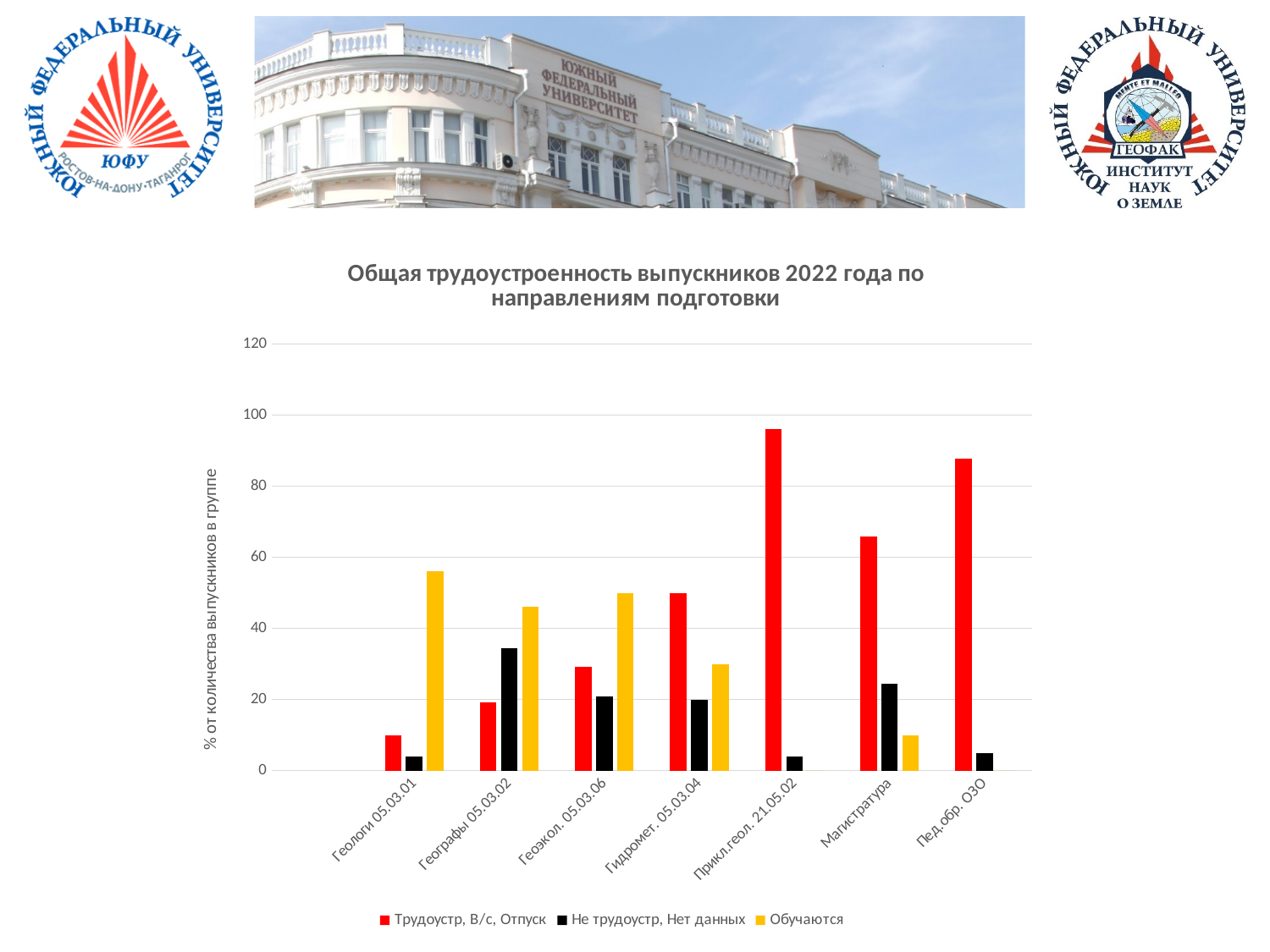
What colour represents the series "Обучаются" in the chart? yellow What kind of chart is shown on the slide? bar chart Which category has the highest value for the series "Обучаются"? Геологи 05.03.01 Is the value of "Обучаются" for Геологи 05.03.01 greater or less than 40? greater Which category has the lowest value for the series "Трудоустр, В/с, Отпуск"? Геологи 05.03.01 How many series does the legend list? 3 For Географы 05.03.02, which is larger: "Трудоустр, В/с, Отпуск" or "Не трудоустр, Нет данных"? Не трудоустр, Нет данных How many categories (directions of training) are shown on the x axis? 7 Is the value of "Трудоустр, В/с, Отпуск" for Магистратура greater or less than 60? greater Is the value of "Трудоустр, В/с, Отпуск" for Прикл.геол. 21.05.02 greater or less than 80? greater Which category has the highest value for the series "Трудоустр, В/с, Отпуск"? Прикл.геол. 21.05.02 Which category has the highest value for the series "Не трудоустр, Нет данных"? Географы 05.03.02